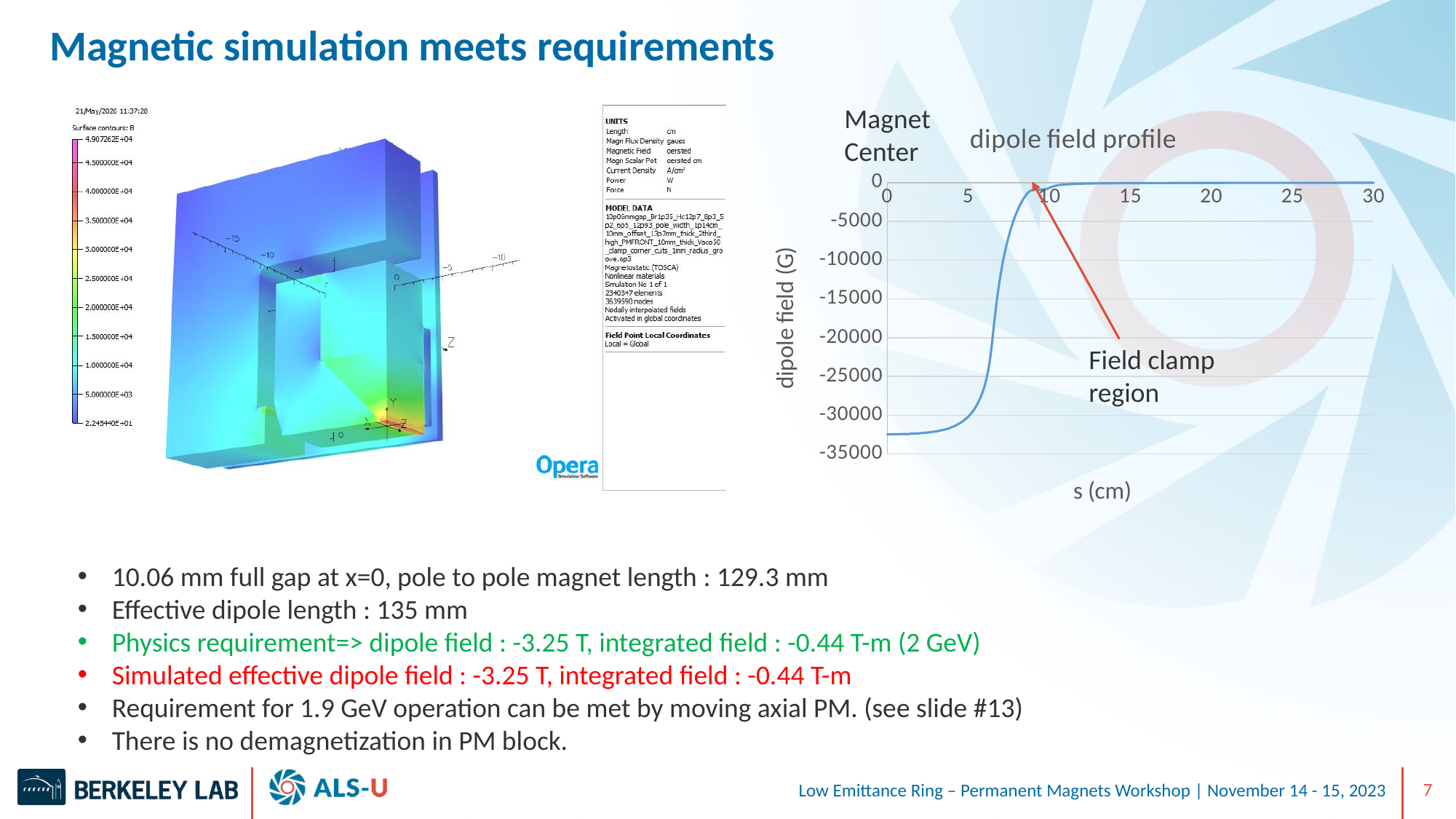
In the "dipole field profile" chart, is the dipole field at s = 15 cm greater or less than -10000 G? greater In the "dipole field profile" chart, is the dipole field at s = 20 cm greater or less than -5000 G? greater In the "dipole field profile" chart, what is the highest value shown on the x axis? 30 What kind of chart is the "dipole field profile" chart? line chart In the "dipole field profile" chart, is the dipole field at s = 5 cm greater or less than -20000 G? less In the "dipole field profile" chart, does the dipole field rise or fall as s increases from 0 to 15 cm? rise In the "dipole field profile" chart, at which end of the s axis is the dipole field closest to 0 G: s = 0 cm or s = 30 cm? s = 30 cm In the "dipole field profile" chart, what is the label of the y axis? dipole field (G) What is the title of the line chart on the right of the slide? dipole field profile In the "dipole field profile" chart, is the dipole field larger at s = 0 cm or at s = 30 cm? s = 30 cm